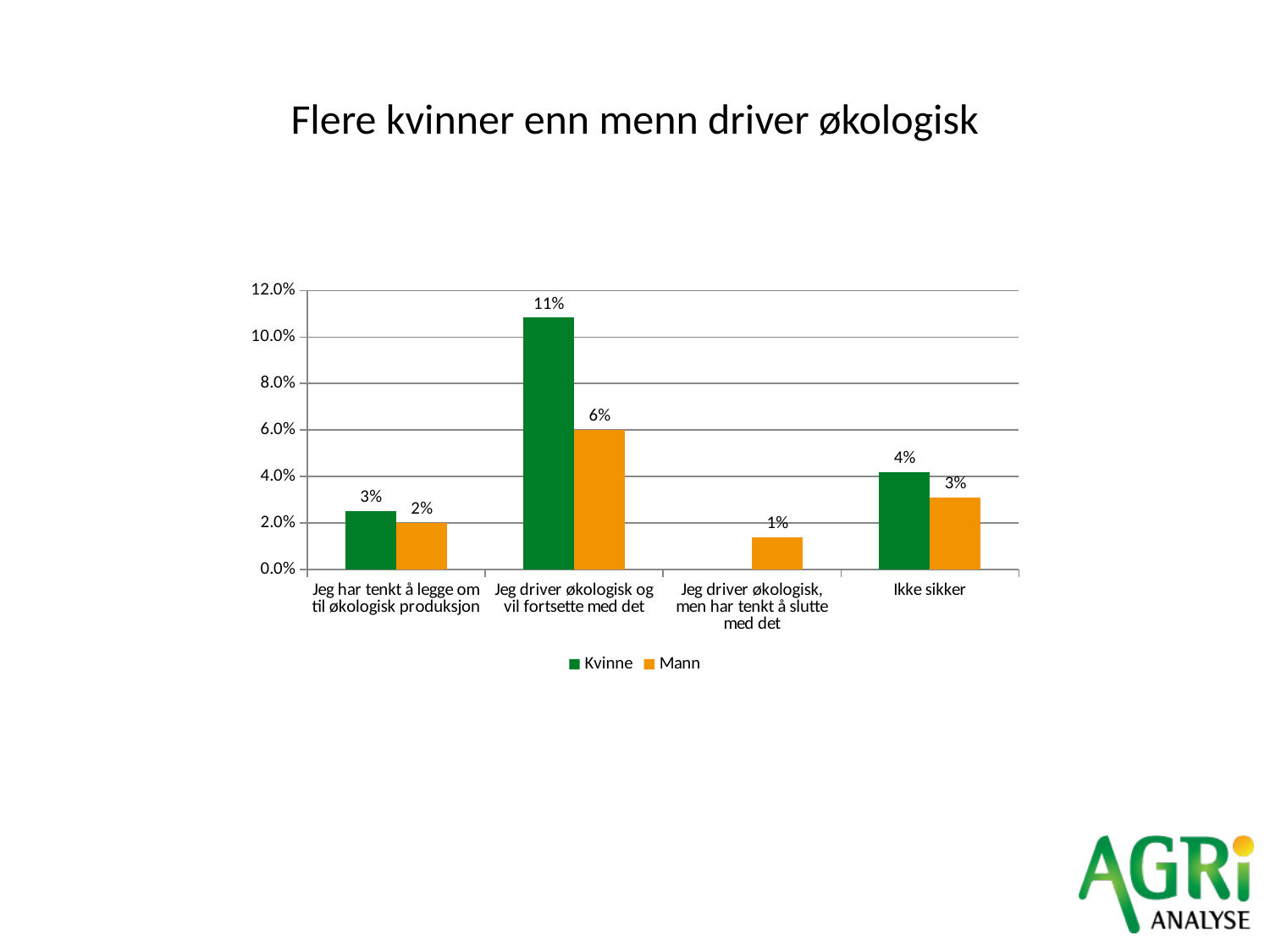
Is the Kvinne value for "Jeg driver økologisk og vil fortsette med det" greater or less than 10.0%? greater What is the value for Kvinne in the category "Jeg driver økologisk og vil fortsette med det"? 11% Which category has the lowest value for Mann? Jeg driver økologisk, men har tenkt å slutte med det What type of chart is shown on the slide? Bar chart How many series does the legend list? 2 What is the value for Kvinne in the category "Ikke sikker"? 4% Which category has the highest value for Kvinne? Jeg driver økologisk og vil fortsette med det What is the value for Mann in the category "Jeg driver økologisk, men har tenkt å slutte med det"? 1% In the category "Ikke sikker", which series has the larger value, Kvinne or Mann? Kvinne What is the value for Mann in the category "Jeg driver økologisk og vil fortsette med det"? 6% What is the value for Mann in the category "Jeg har tenkt å legge om til økologisk produksjon"? 2% What is the difference between the Kvinne and Mann values in the category "Jeg driver økologisk og vil fortsette med det"? 5%